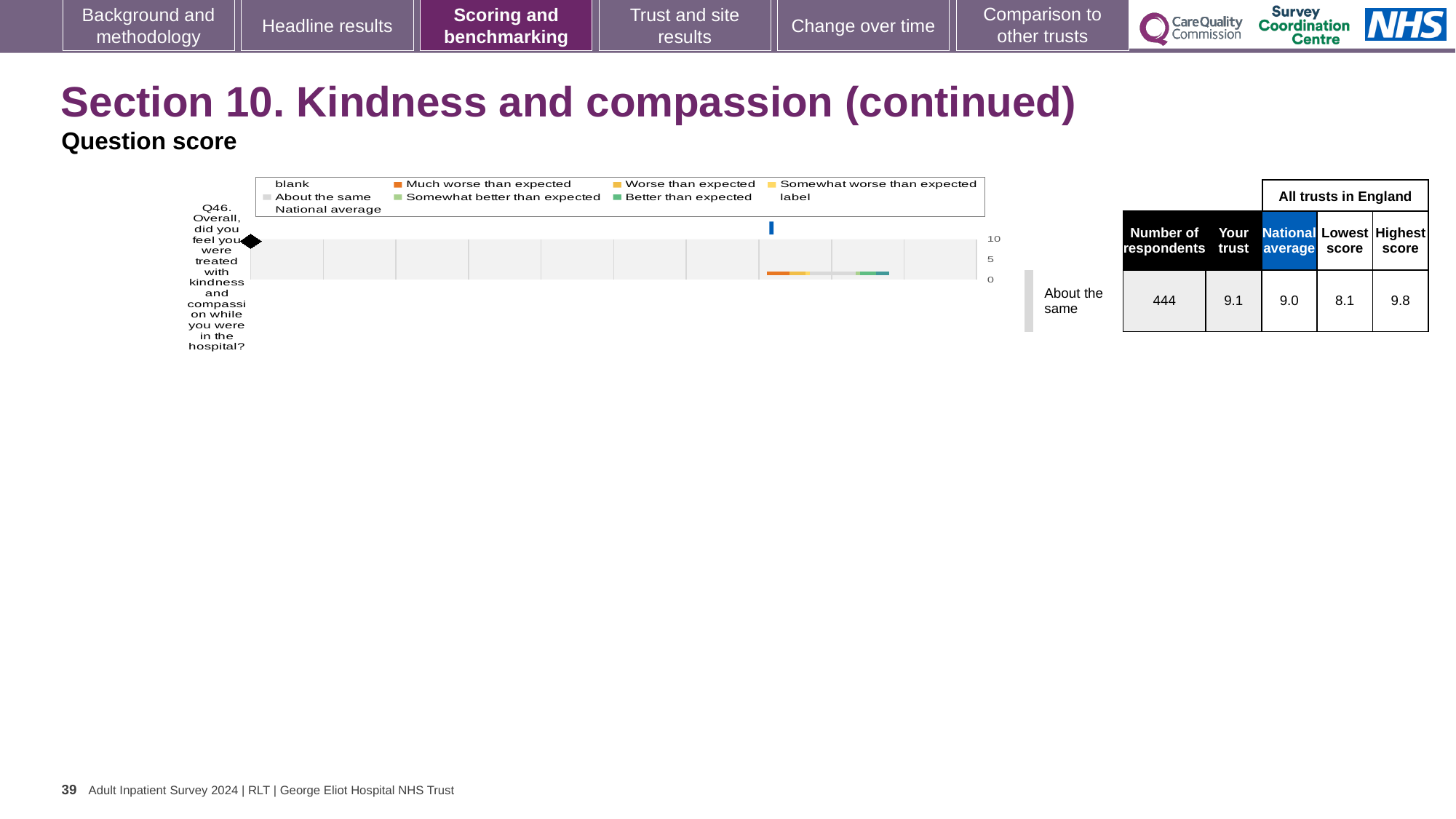
What benchmark category is the trust's Q46 score placed in? About the same What is the 'Your trust' score for Q46? 9.1 How many questions (categories) are plotted on the chart? 1 What is the difference between the highest score and the lowest score for Q46? 1.7 Which question is plotted on the chart? Q46. Overall, did you feel you were treated with kindness and compassion while you were in the hospital? How many respondents answered Q46? 444 What is the highest score among all trusts in England for Q46? 9.8 What is the lowest score among all trusts in England for Q46? 8.1 Which is larger for Q46, the 'Your trust' score or the national average? Your trust What kind of chart is shown on the slide? bar chart What is the highest tick value shown on the chart's axis? 10 What is the national average score for Q46? 9.0